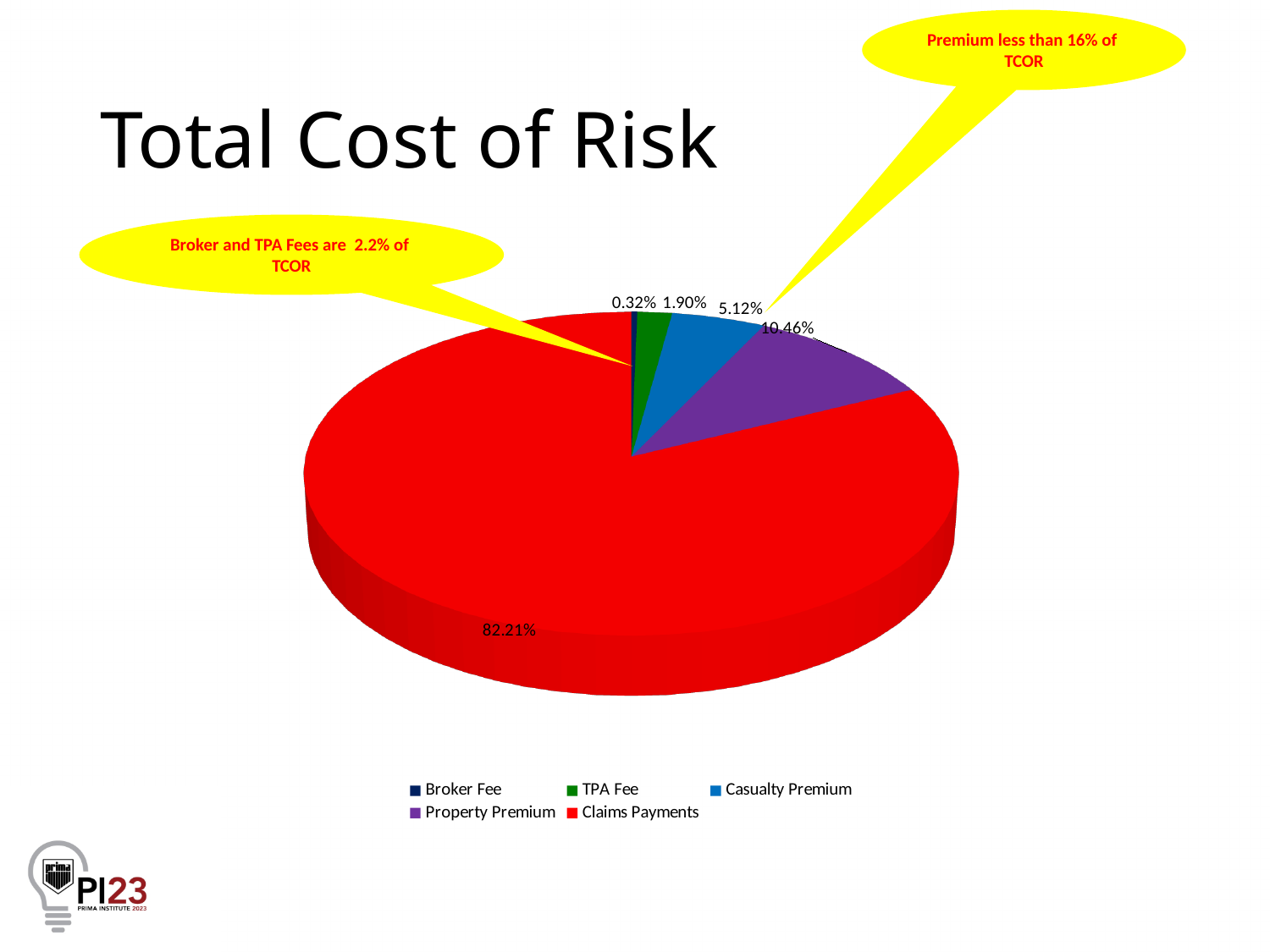
Which category has the largest slice of the pie? Claims Payments What is the value shown for Property Premium? 10.46% What is the difference between the Property Premium and Casualty Premium shares? 5.34% What is the title of the slide containing the chart? Total Cost of Risk What kind of chart is shown on the slide? pie chart How many categories does the legend list? 5 What is the value shown for Casualty Premium? 5.12% What share of the pie does Claims Payments represent? 82.21% Which category has the smallest slice of the pie? Broker Fee What is the value shown for Broker Fee? 0.32% What is the value shown for TPA Fee? 1.90% Which is larger, Property Premium or Casualty Premium? Property Premium